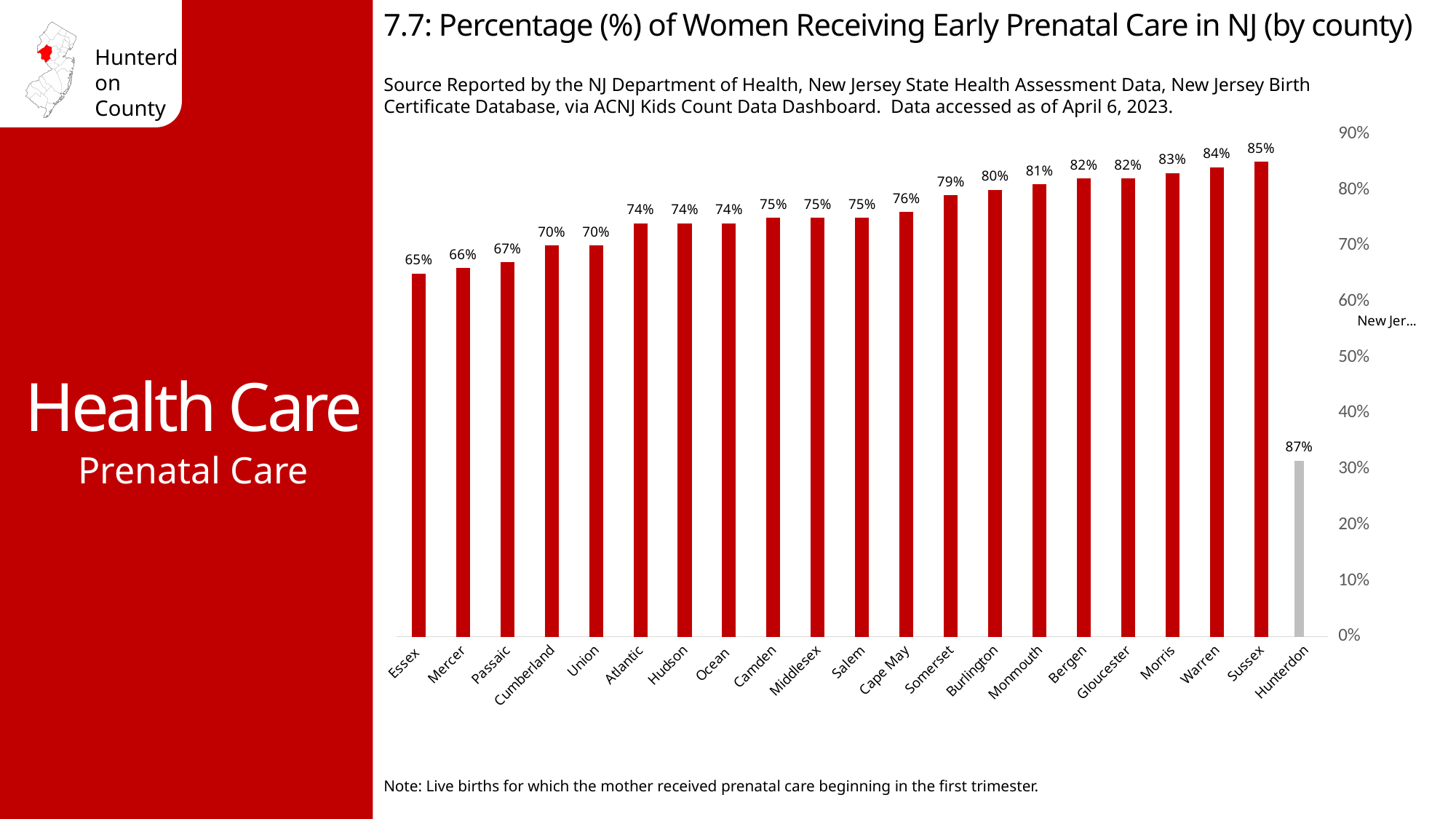
Which is larger, the value for Morris or the value for Cape May? Morris What percentage of women received early prenatal care in Bergen county? 82% Do the values generally rise or fall from Essex to Sussex along the x axis? Rise What kind of chart is shown on the slide? Bar chart What is the difference between the values for Sussex and Essex? 20 percentage points What is the value shown for Cumberland? 70% What is the difference between the values for Warren and Burlington? 4 percentage points Which county has the lowest percentage of women receiving early prenatal care? Essex How many counties are shown on the x axis? 21 Which county's bar is coloured gray instead of red? Hunterdon What is the value for Somerset? 79% Is the value for Union greater or less than 60%? greater